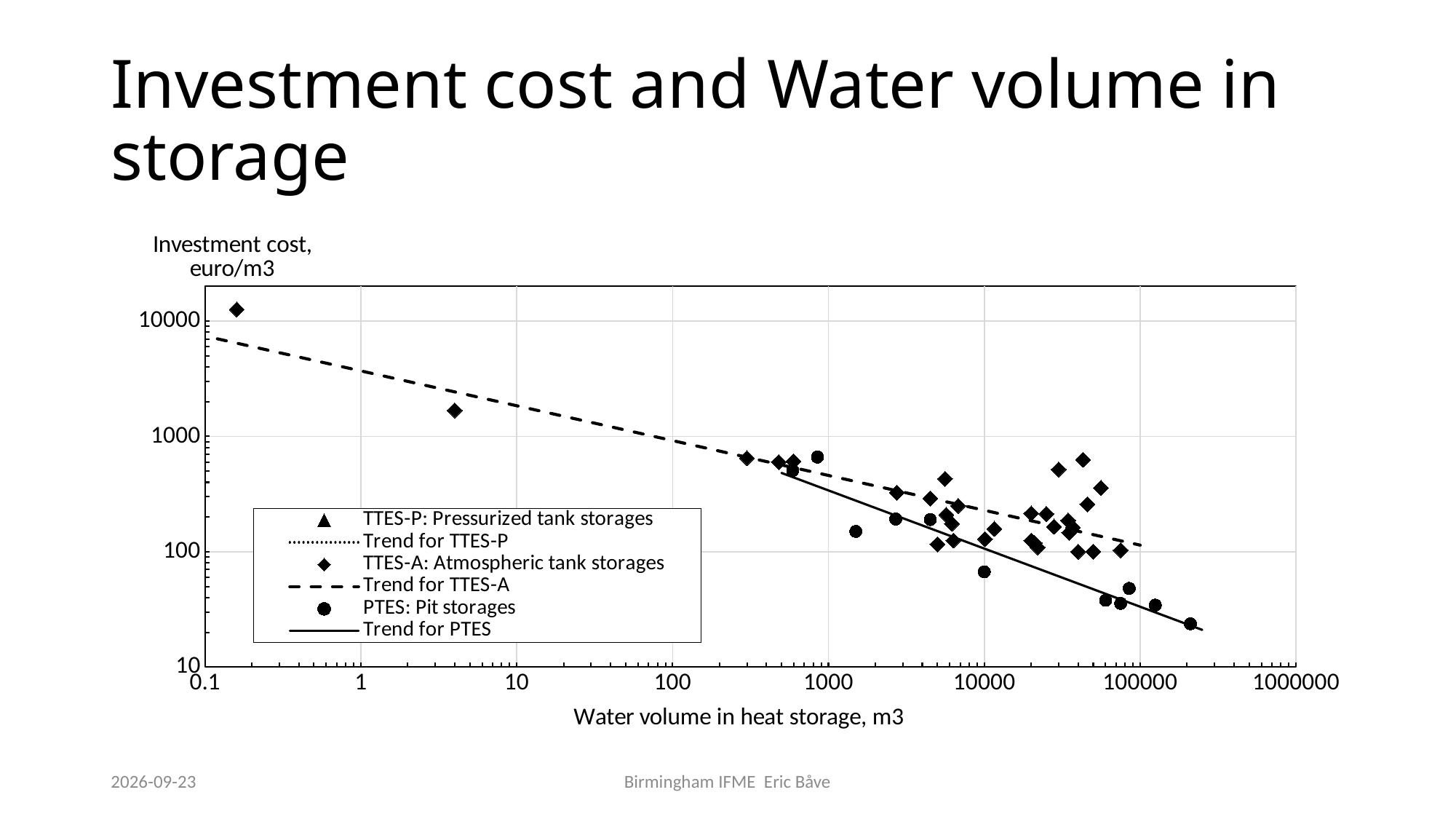
Is the investment cost of the TTES-A point at about 4 m3 greater or less than 1000 euro/m3? greater Is the investment cost of the TTES-A point with the smallest water volume (near 0.1 m3) greater or less than 1000 euro/m3? greater What is the label of the x axis? Water volume in heat storage, m3 Which has the higher investment cost: the TTES-A point at about 4 m3 or the PTES point at about 200000 m3? the TTES-A point at about 4 m3 Is the investment cost of the PTES point with the largest water volume (near 200000 m3) greater or less than 100 euro/m3? less Which legend entry is drawn as a solid line? Trend for PTES How many entries does the chart legend list? 6 What is the highest value labelled on the y axis? 10000 Which series contains the point with the lowest investment cost on the chart? PTES: Pit storages What kind of chart is shown on the slide? scatter chart As water volume in heat storage increases along the x axis, does the investment cost per m3 generally rise or fall? fall Which series contains the point with the highest investment cost on the chart? TTES-A: Atmospheric tank storages